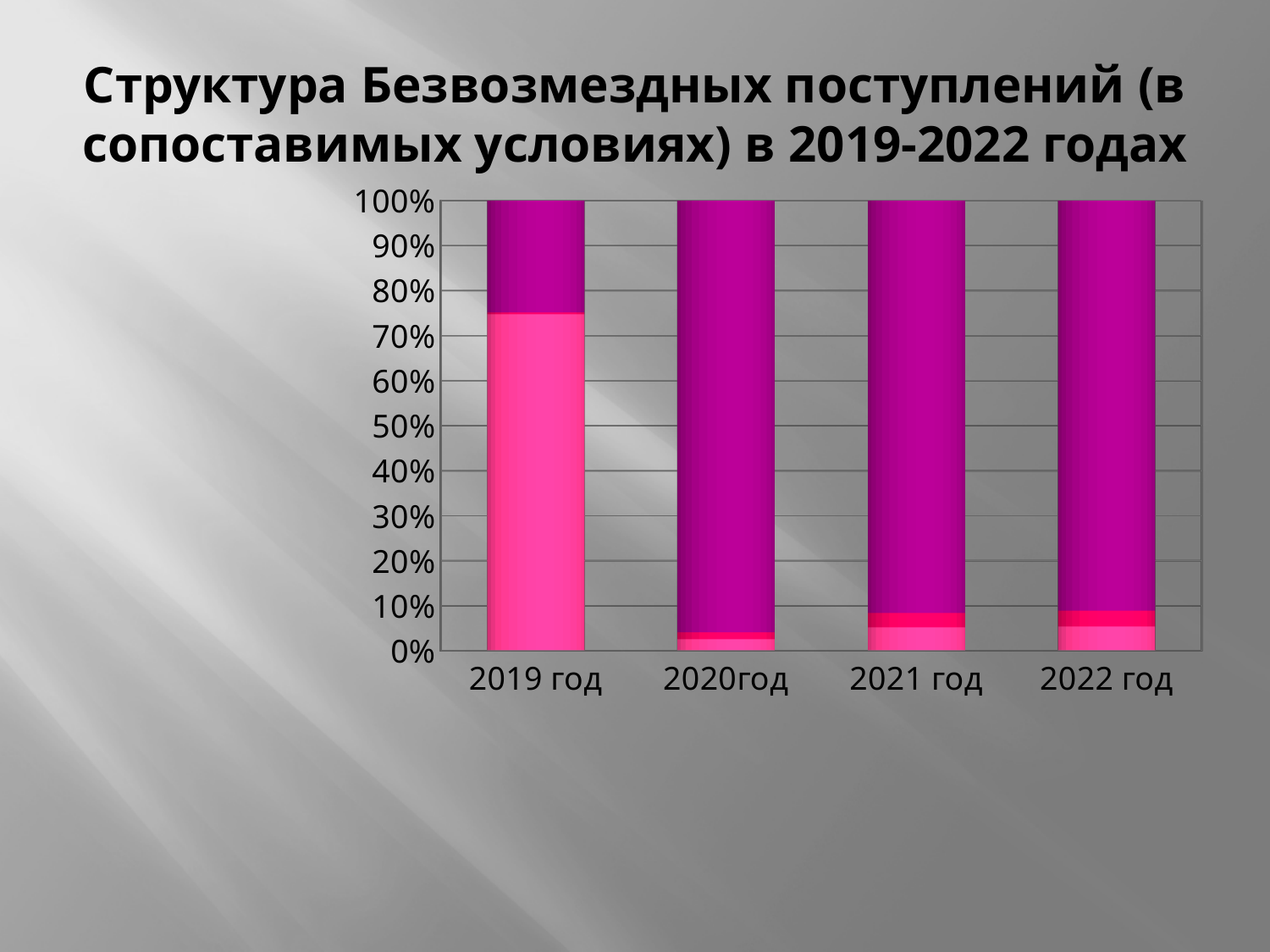
Which year has the largest lower (pink) segment? 2019 год Is the upper (purple) segment for 2019 год greater or less than 30%? less Is the lower (pink) segment for 2019 год greater or less than 80%? less What is the highest value shown on the vertical axis of the chart? 100% Is the lower (pink) segment for 2020год greater or less than 10%? less Which year has the larger upper (purple) segment, 2019 год or 2020год? 2020год What kind of chart is shown on the slide? stacked bar chart Which year has the smallest lower (pink) segment? 2020год How many years (categories) are shown on the x axis of the chart? 4 Which year has the larger lower (pink) segment, 2019 год or 2021 год? 2019 год